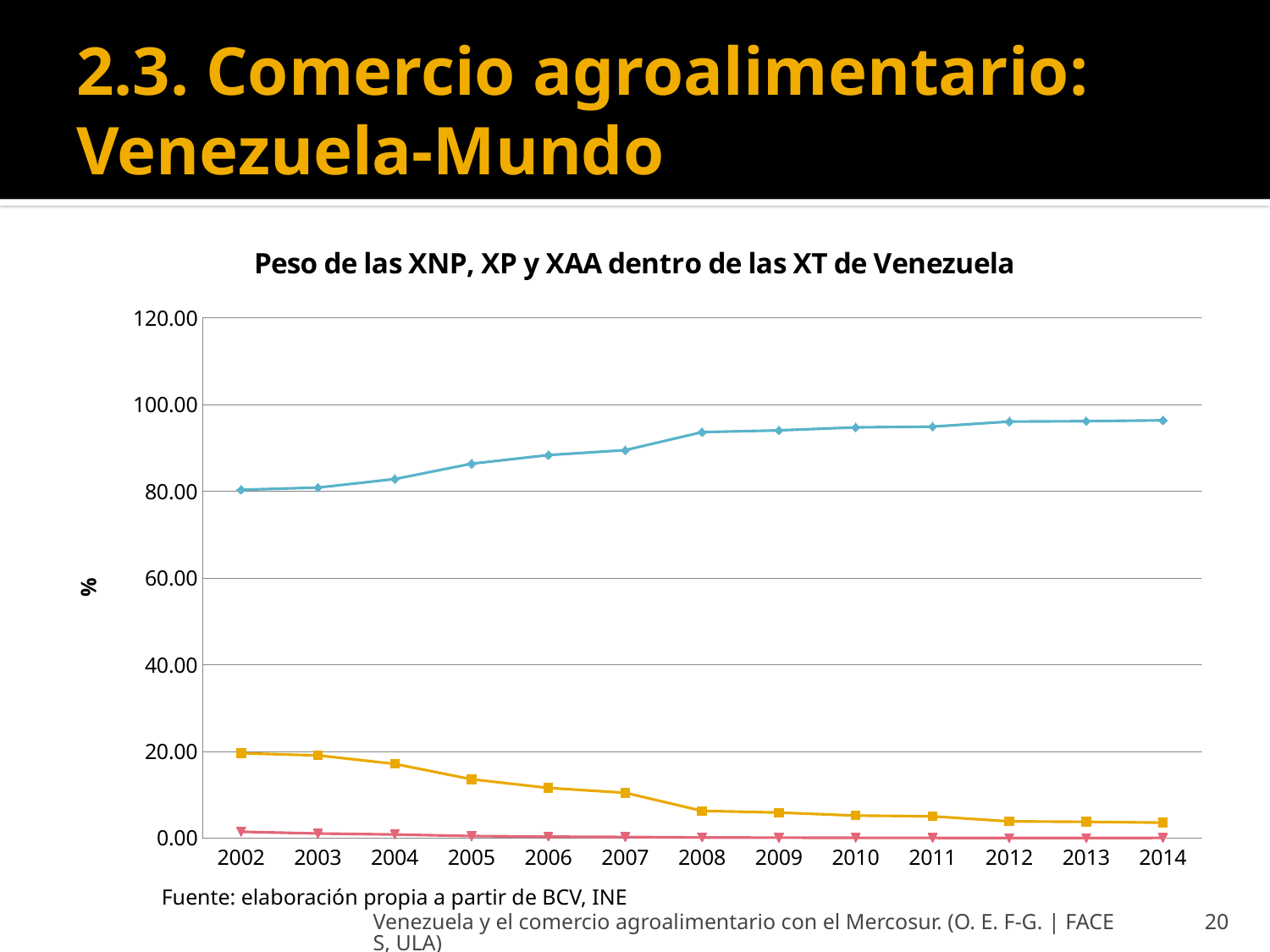
Is the value of the middle (orange) line in 2008 greater or less than 20? less What kind of chart is shown on the slide? line chart Is the value of the top (blue) line in 2014 greater or less than 100? less What is the title of the chart? Peso de las XNP, XP y XAA dentro de las XT de Venezuela In 2010, which line has the larger value, the blue line or the orange line? the blue line How many years are plotted along the x axis of the chart? 13 Does the top (blue) line rise or fall from 2002 to 2014? rise What is the last year shown on the x axis? 2014 Does the middle (orange) line rise or fall from 2002 to 2014? fall What is the label on the vertical axis of the chart? % Is the value of the top (blue) line in 2008 greater or less than 80? greater What is the first year shown on the x axis? 2002